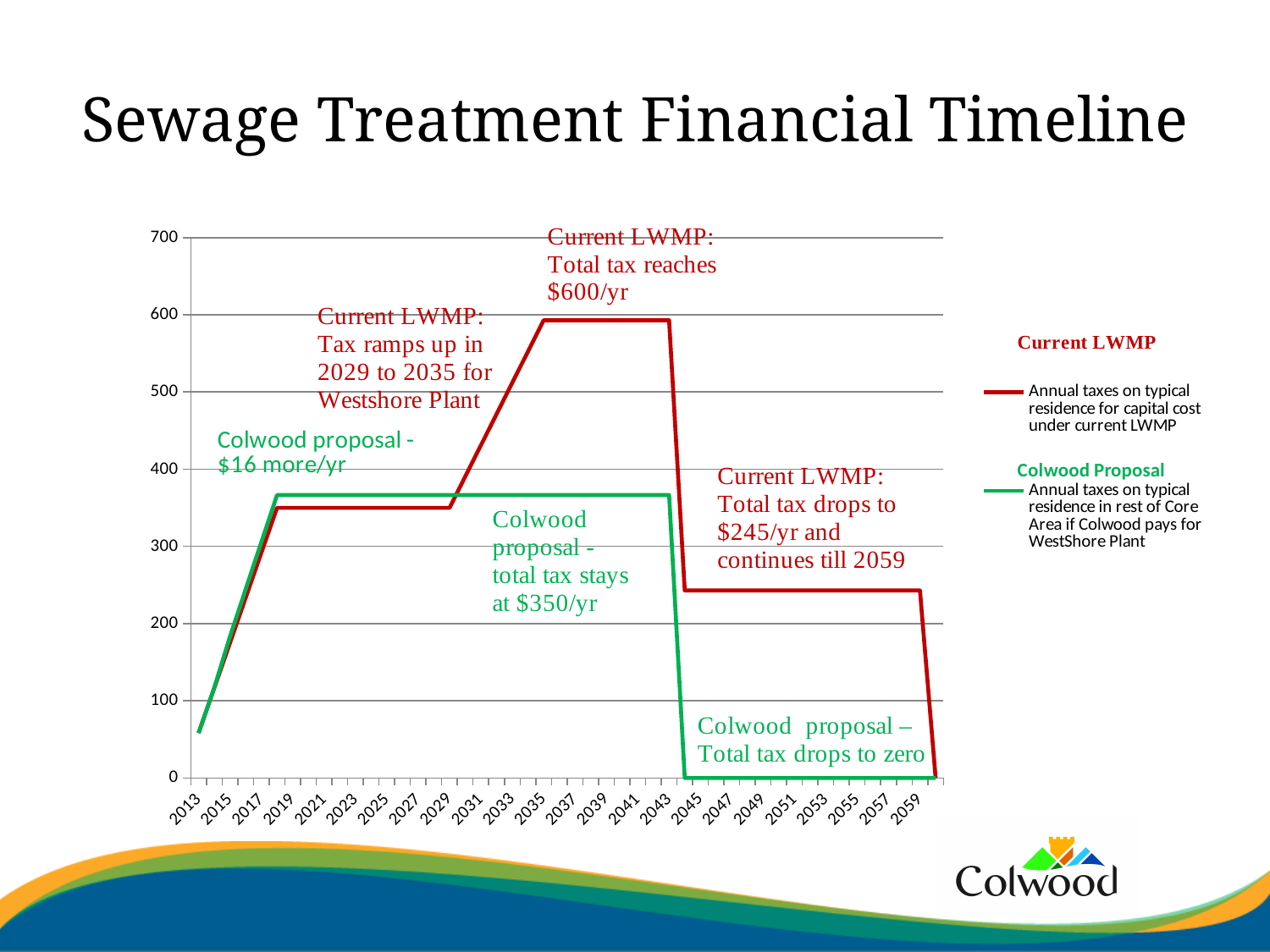
What is the title of the slide's chart? Sewage Treatment Financial Timeline Is the value for Current LWMP in 2057 greater or less than 200? greater Does the Current LWMP series rise or fall between 2029 and 2035? rise What kind of chart is shown on the slide? line chart Is the value for Current LWMP in 2039 greater or less than 500? greater In 2039, which series has the higher value, Current LWMP or Colwood Proposal? Current LWMP Is the value for Current LWMP in 2051 greater or less than 300? less How many series does the legend list? 2 How many year labels are shown on the x axis? 24 According to the annotation on the chart, what does the Current LWMP total tax drop to after 2043? $245/yr What is the value of the Colwood Proposal series in 2051? 0